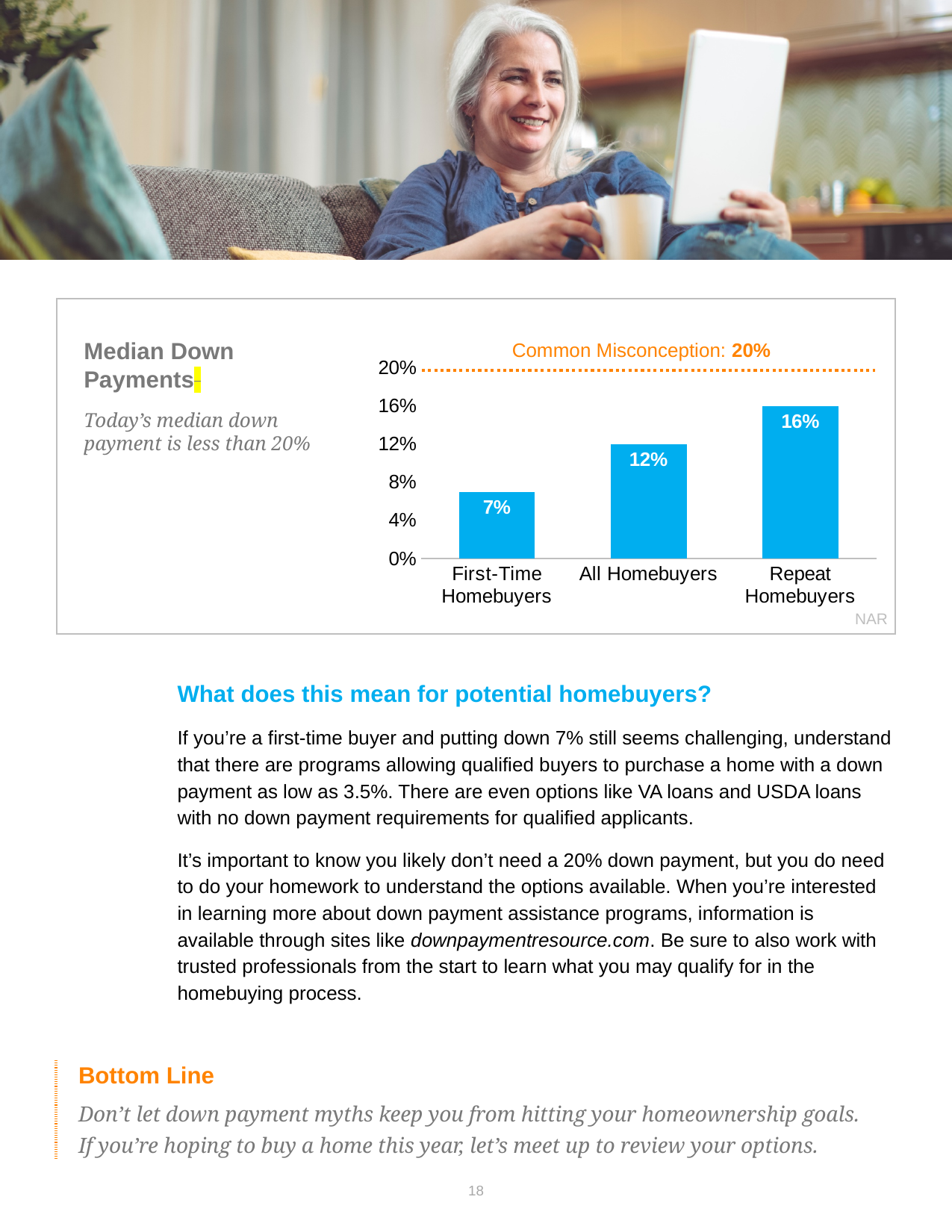
How many categories are shown in the chart? 3 What is the difference between the median down payment for Repeat Homebuyers and First-Time Homebuyers? 9% Which category has the highest median down payment? Repeat Homebuyers What is the median down payment for First-Time Homebuyers? 7% Is the value for Repeat Homebuyers greater or less than 20%? less Which is larger, the median down payment for All Homebuyers or for First-Time Homebuyers? All Homebuyers Which category has the lowest median down payment? First-Time Homebuyers What is the median down payment for All Homebuyers? 12% What kind of chart is shown on the slide? Bar chart What value does the dashed line labeled 'Common Misconception' mark? 20% What is the difference between the median down payment for All Homebuyers and First-Time Homebuyers? 5% What is the median down payment for Repeat Homebuyers? 16%